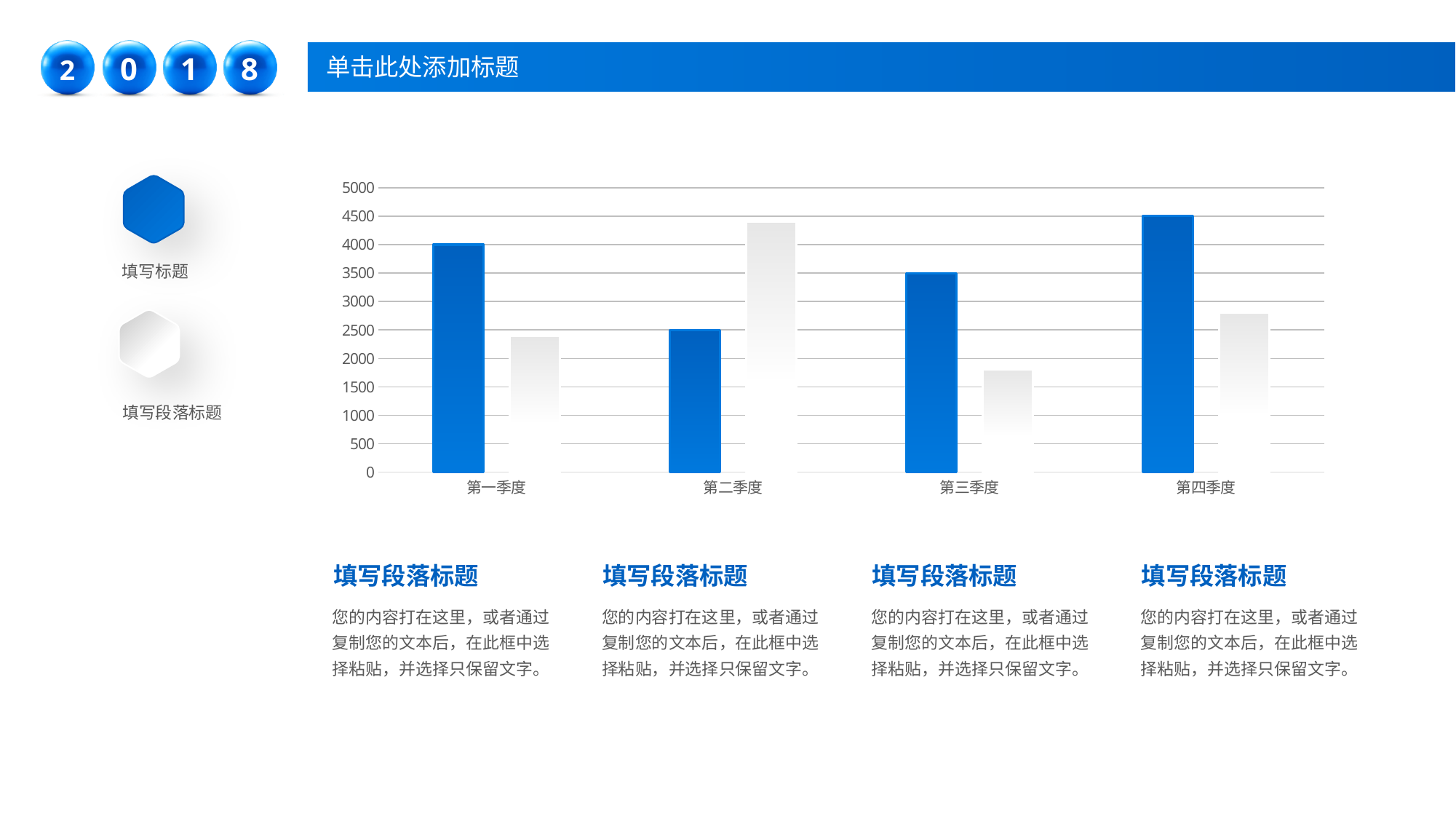
Is the value of the grey bar for 第二季度 greater or less than 4000? greater For 第二季度, which bar is larger, the blue bar or the grey bar? the grey bar What is the value of the blue bar for 第一季度? 4000 Which category has the lowest blue bar? 第二季度 What kind of chart is shown on the slide? bar chart Which category has the highest blue bar? 第四季度 Is the value of the grey bar for 第三季度 greater or less than 2000? less Which category has the lowest grey bar? 第三季度 What is the difference between the blue bar for 第四季度 and the blue bar for 第二季度? 2000 How many categories are shown on the x axis of the chart? 4 What is the value of the blue bar for 第二季度? 2500 What is the value of the blue bar for 第四季度? 4500